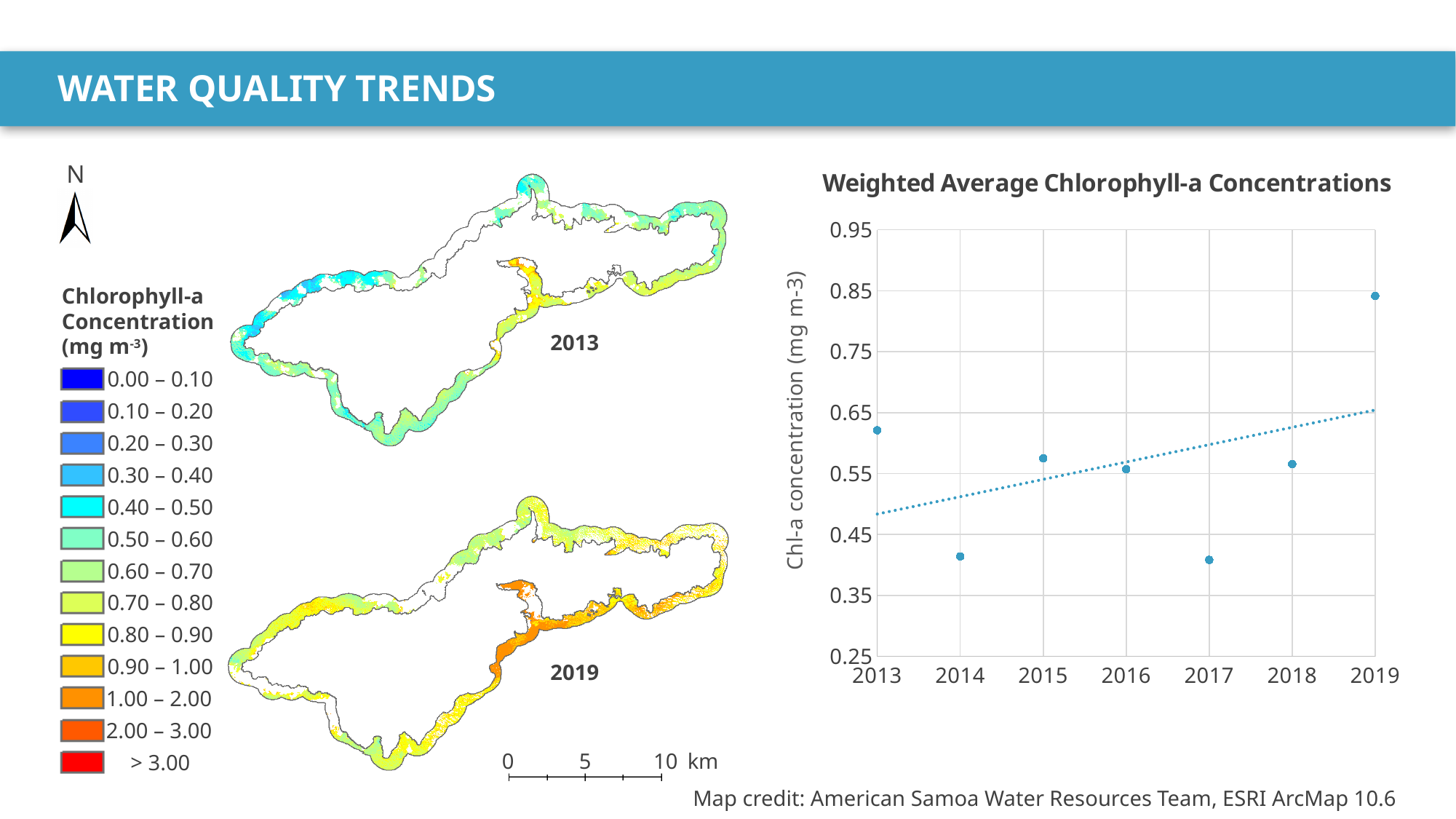
In the 'Weighted Average Chlorophyll-a Concentrations' chart, is the value for 2017 greater or less than 0.45? less In the 'Weighted Average Chlorophyll-a Concentrations' chart, how many years are plotted? 7 What kind of chart is the 'Weighted Average Chlorophyll-a Concentrations' chart? scatter chart In the 'Weighted Average Chlorophyll-a Concentrations' chart, which is larger, the value for 2018 or the value for 2017? 2018 In the 'Weighted Average Chlorophyll-a Concentrations' chart, which is larger, the value for 2013 or the value for 2014? 2013 In the 'Weighted Average Chlorophyll-a Concentrations' chart, is the value for 2013 greater or less than 0.55? greater In the 'Weighted Average Chlorophyll-a Concentrations' chart, is the value for 2014 greater or less than 0.45? less In the 'Weighted Average Chlorophyll-a Concentrations' chart, which year has the highest Chl-a concentration? 2019 In the 'Weighted Average Chlorophyll-a Concentrations' chart, does the dotted trend line rise or fall from 2013 to 2019? rise What is the lowest value shown on the y-axis of the 'Weighted Average Chlorophyll-a Concentrations' chart? 0.25 What is the y-axis label of the 'Weighted Average Chlorophyll-a Concentrations' chart? Chl-a concentration (mg m-3)